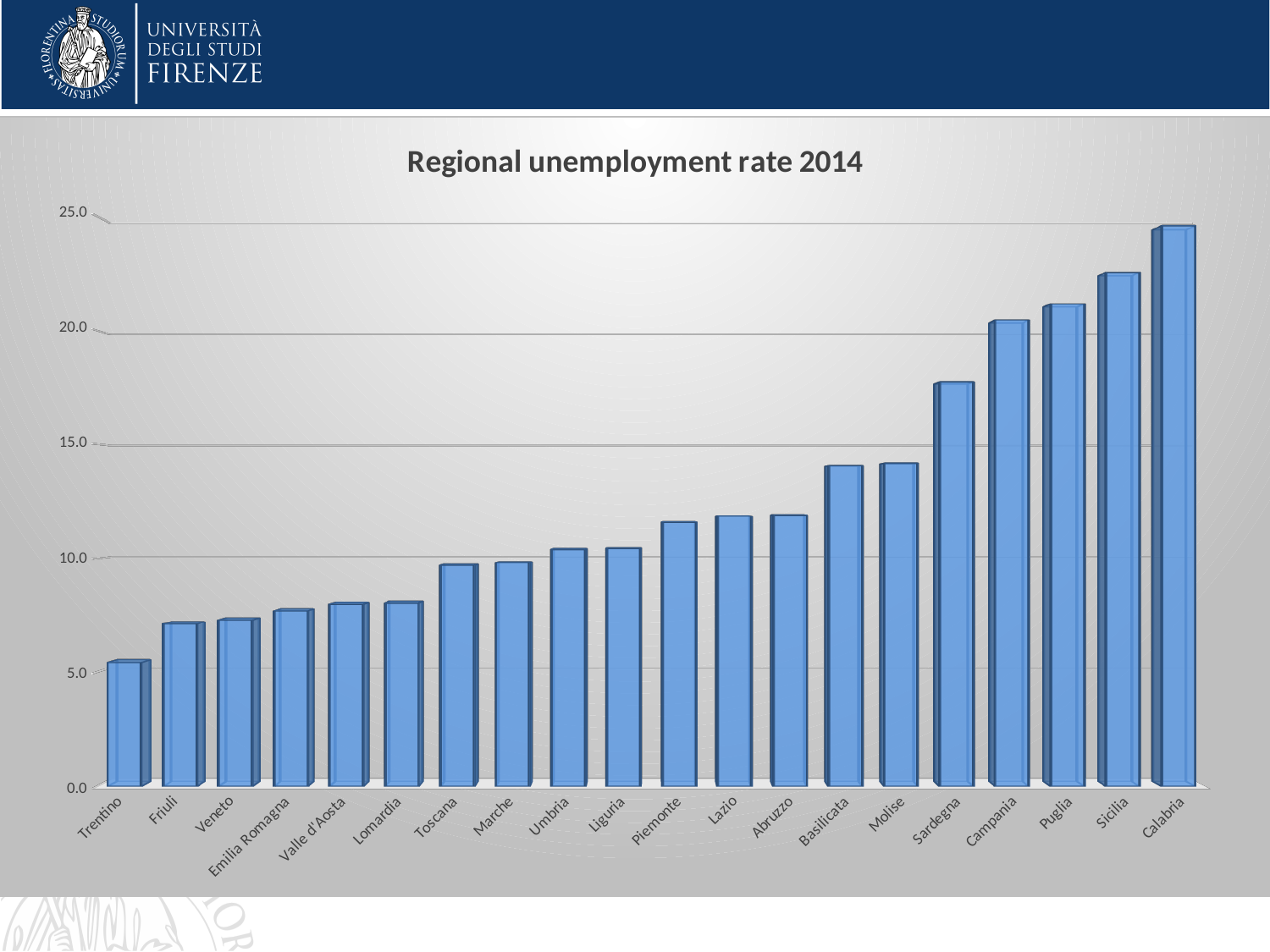
Which has a higher unemployment rate, Sicilia or Calabria? Calabria Which region has the highest unemployment rate in the chart? Calabria How many regions are shown on the x axis of the chart? 20 Which region has the lowest unemployment rate in the chart? Trentino What type of chart is shown on the slide? bar chart Is the value for Basilicata greater or less than 15.0? less Is the value for Sardegna greater or less than 15.0? greater What is the title of the chart? Regional unemployment rate 2014 Do the values rise or fall moving from left to right along the x axis? rise Is the value for Lombardia greater or less than 10.0? less Which has a higher unemployment rate, Trentino or Friuli? Friuli